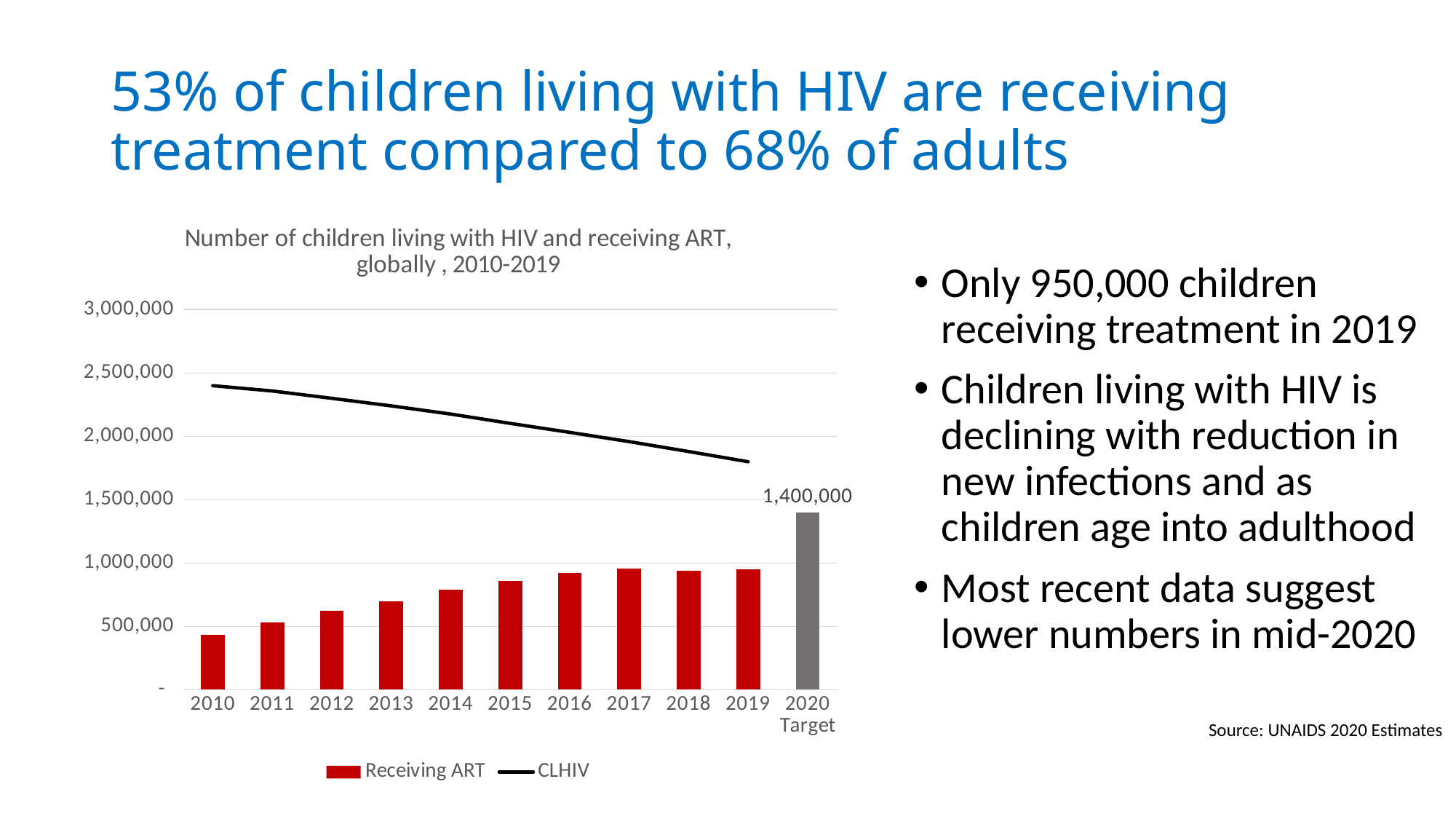
Do the Receiving ART bars generally rise or fall from 2010 to 2019? rise How many categories are shown on the x axis of the chart? 11 Which is larger, the Receiving ART value for 2010 or for 2015? 2015 Is the Receiving ART value for 2019 greater or less than 1,000,000? less Which year has the lowest Receiving ART value? 2010 What is the value shown for the 2020 Target bar? 1,400,000 Is the CLHIV value for 2010 greater or less than 2,000,000? greater Is the Receiving ART value for 2010 greater or less than 500,000? less Does the CLHIV line rise or fall from 2010 to 2019? fall What kind of chart is shown on the slide? A bar chart combined with a line How many series does the chart legend list? 2